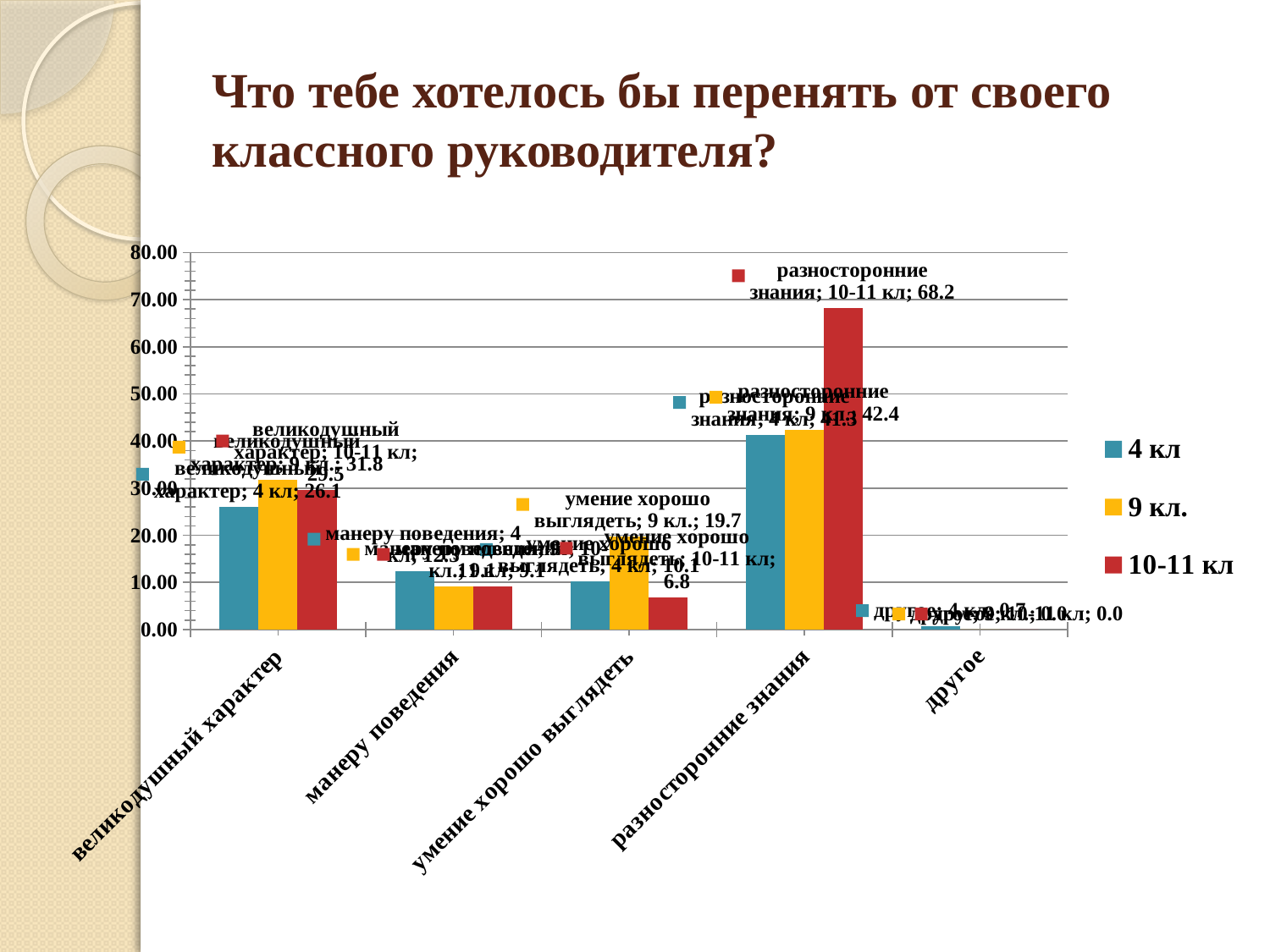
What is the value for 9 кл. in the category умение хорошо выглядеть? 19.7 What is the difference between the 10-11 кл and 9 кл. values in the category разносторонние знания? 25.8 In the category великодушный характер, which is larger: the value for 4 кл or for 9 кл.? 9 кл. What is the value for 10-11 кл in the category умение хорошо выглядеть? 6.8 What are the three series listed in the legend? 4 кл, 9 кл., 10-11 кл What is the value for 10-11 кл in the category разносторонние знания? 68.2 How many categories are shown on the x axis? 5 Which category has the highest value for the 10-11 кл series? разносторонние знания How many series does the legend list? 3 What kind of chart is shown on the slide? bar chart Is the value for 4 кл in the category манеру поведения greater or less than 20? less